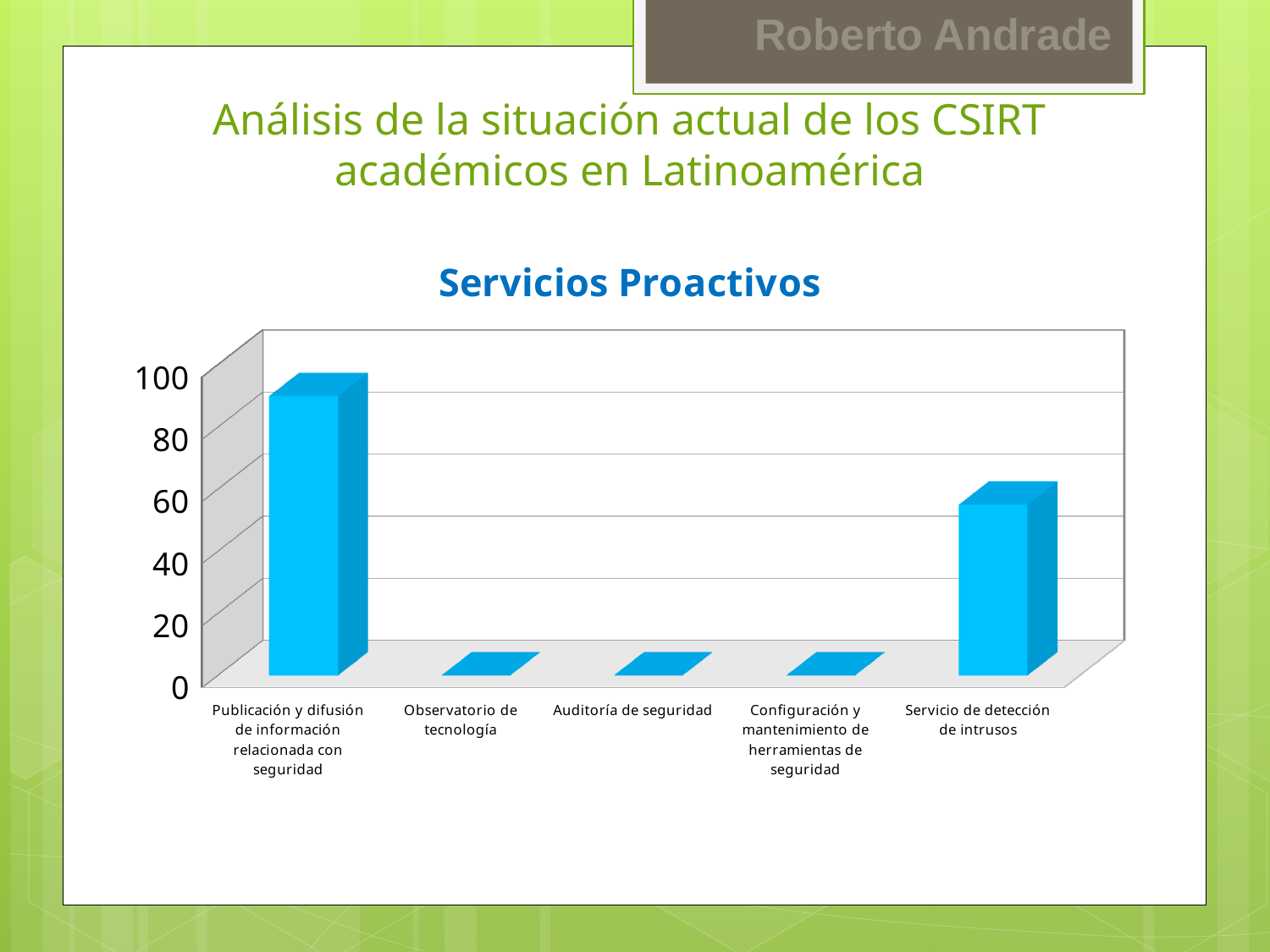
How many categories are shown on the x axis of the chart? 5 How many categories in the chart have a bar rising above 0? 2 Is the value for Servicio de detección de intrusos greater or less than 40? greater Which category has the highest value in the chart? Publicación y difusión de información relacionada con seguridad What is the title of the chart? Servicios Proactivos Is the value for Publicación y difusión de información relacionada con seguridad greater or less than 80? greater What kind of chart is shown on the slide? bar chart Which is larger: the value for Publicación y difusión de información relacionada con seguridad or the value for Servicio de detección de intrusos? Publicación y difusión de información relacionada con seguridad What colour are the bars in the chart? blue Is the value for Observatorio de tecnología greater or less than 20? less What is the value for Auditoría de seguridad? 0